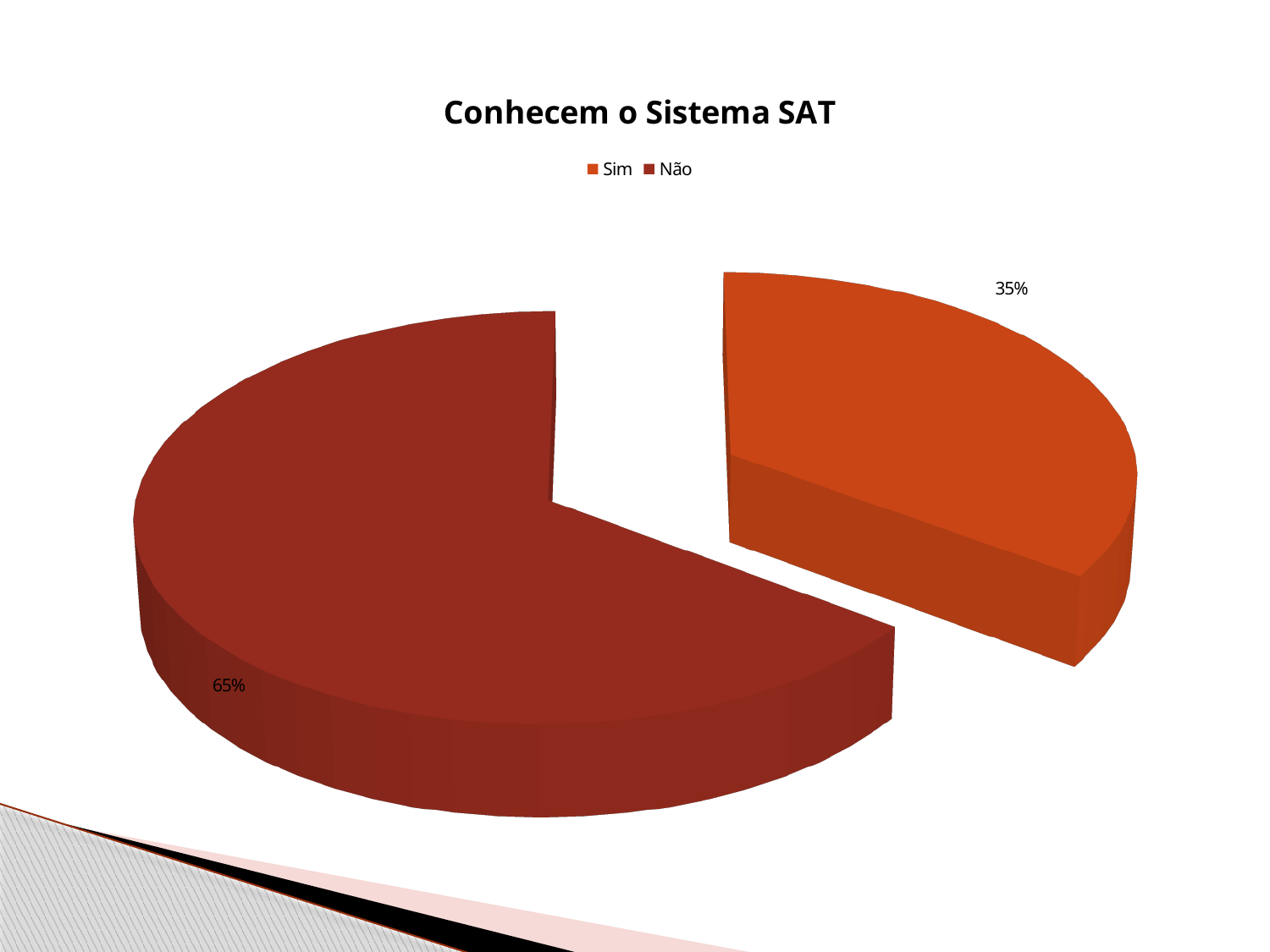
What is the difference in percentage points between the 'Não' and 'Sim' slices? 30 Which category has the smallest slice of the pie? Sim Which category has the largest slice of the pie? Não How many slices does the pie chart have? 2 How many entries does the legend list? 2 Which is larger, the 'Sim' slice or the 'Não' slice? Não What share of the pie does the 'Sim' slice represent? 35% What kind of chart is shown on the slide? pie chart What is the title of the chart? Conhecem o Sistema SAT What share of the pie does the 'Não' slice represent? 65% Which legend entry is shown in the lighter orange colour? Sim